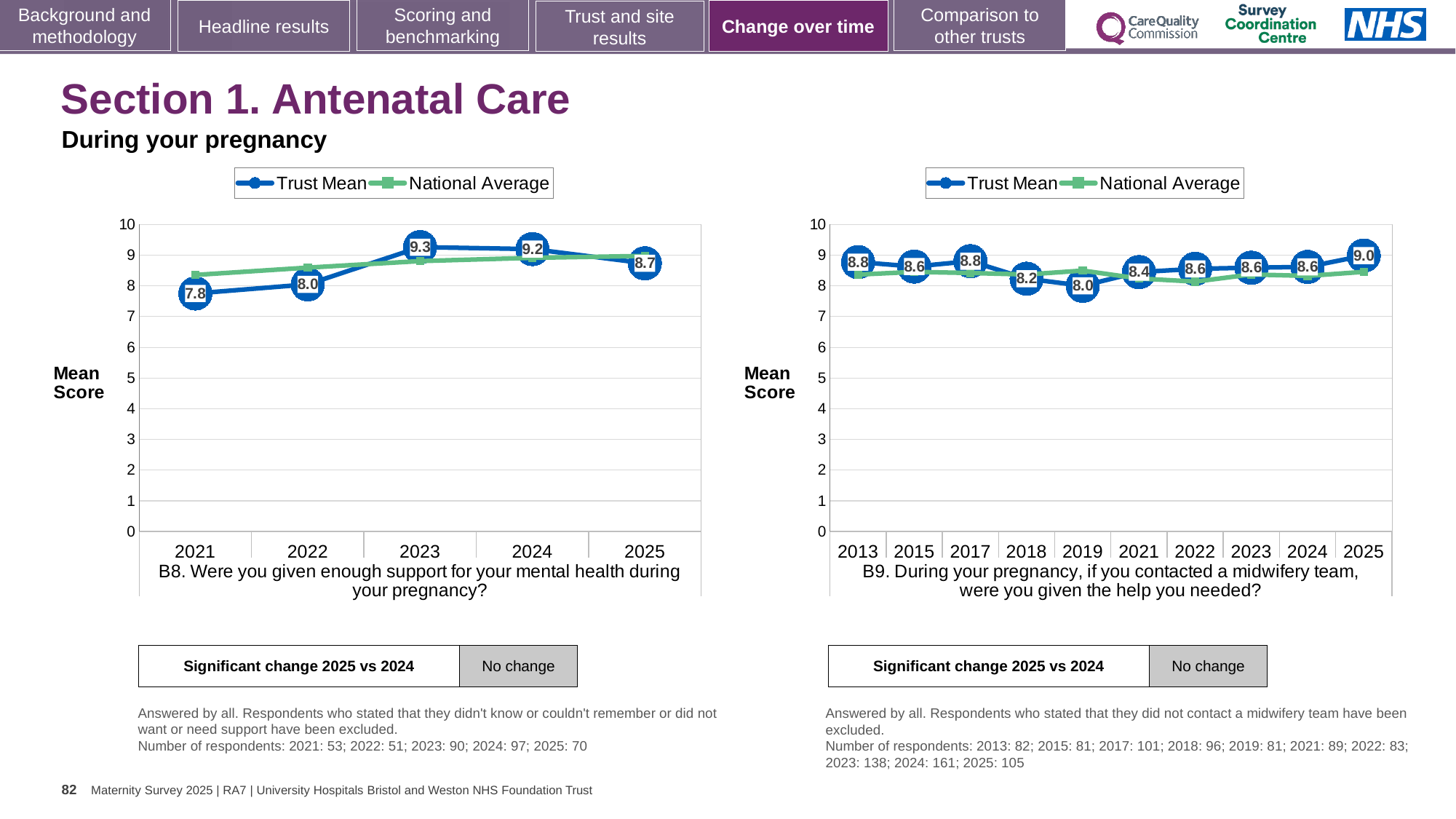
In the B8 chart, what is the Trust Mean for 2021? 7.8 In the B9 chart, which year has the lowest Trust Mean? 2019 In the B8 chart, what is the difference between the Trust Mean in 2023 and in 2021? 1.5 In the B9 chart, how many years are shown on the x axis? 10 In the B8 chart, is the National Average for 2021 greater or less than 8? greater In the B8 chart, how many years are shown on the x axis? 5 In the B9 chart, what is the Trust Mean for 2025? 9.0 In the B8 chart, which year has the highest Trust Mean? 2023 In the B9 chart, is the Trust Mean higher in 2017 or in 2018? 2017 In the B8 chart, what is the Trust Mean for 2023? 9.3 How many series does the legend of the B9 chart list? 2 What type of chart is the B8 chart? Line chart